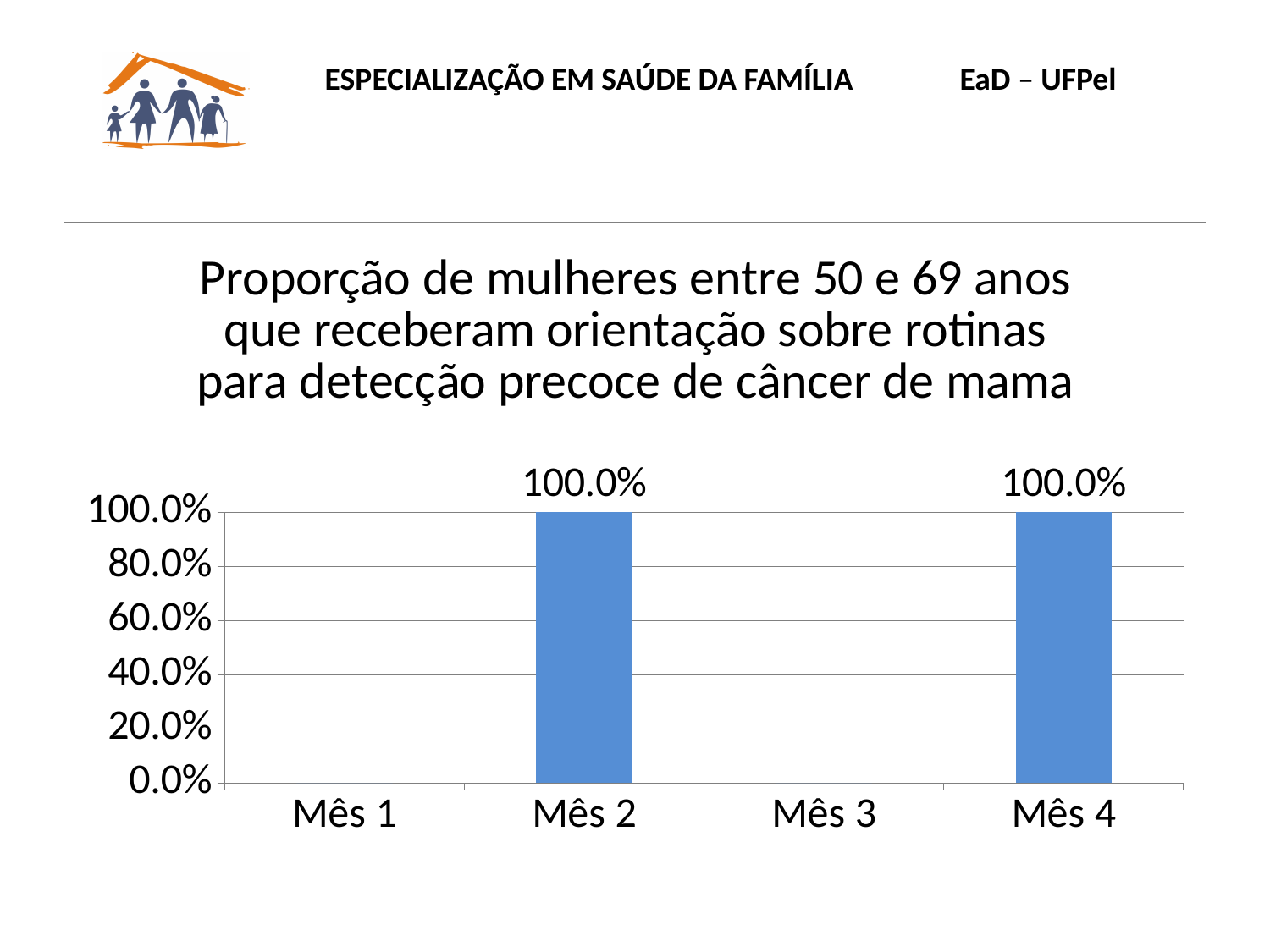
What is the title of the chart? Proporção de mulheres entre 50 e 69 anos que receberam orientação sobre rotinas para detecção precoce de câncer de mama Is the value for Mês 4 greater or less than 60.0%? greater How many categories are shown on the x axis? 4 What is the highest value shown on the y axis? 100.0% What is the value for Mês 2? 100.0% What is the difference between the values for Mês 2 and Mês 4? 0.0% What type of chart is shown on the slide? bar chart Which months have a bar plotted in the chart? Mês 2 and Mês 4 What is the value for Mês 4? 100.0% Is the value for Mês 2 greater or less than 80.0%? greater